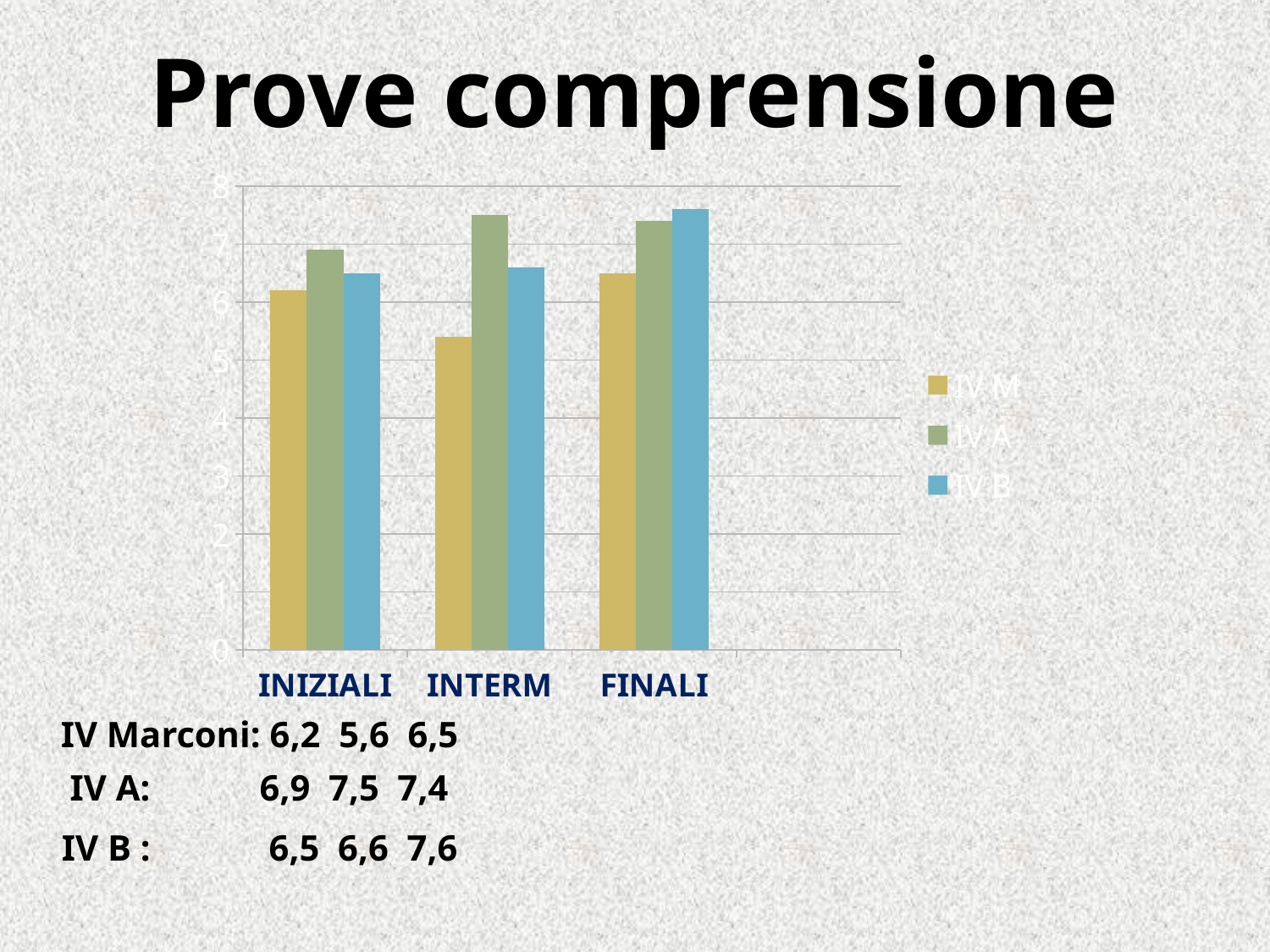
Which series has the lowest value in the INTERM category? IV M What kind of chart is shown on the slide? bar chart Do the values for IV B rise or fall from INIZIALI to FINALI? rise Which series has the highest value in the FINALI category? IV B What is the value for IV B in the FINALI category? 7,6 What is the difference between the IV A and IV Marconi values in the INTERM category? 1,9 What is the value for IV A in the INTERM category? 7,5 What is the title of the slide's chart? Prove comprensione What is the value for IV Marconi in the INTERM category? 5,6 How many series does the legend list? 3 Is the value for IV Marconi in INTERM greater or less than 6? less How many categories are shown on the x axis? 3